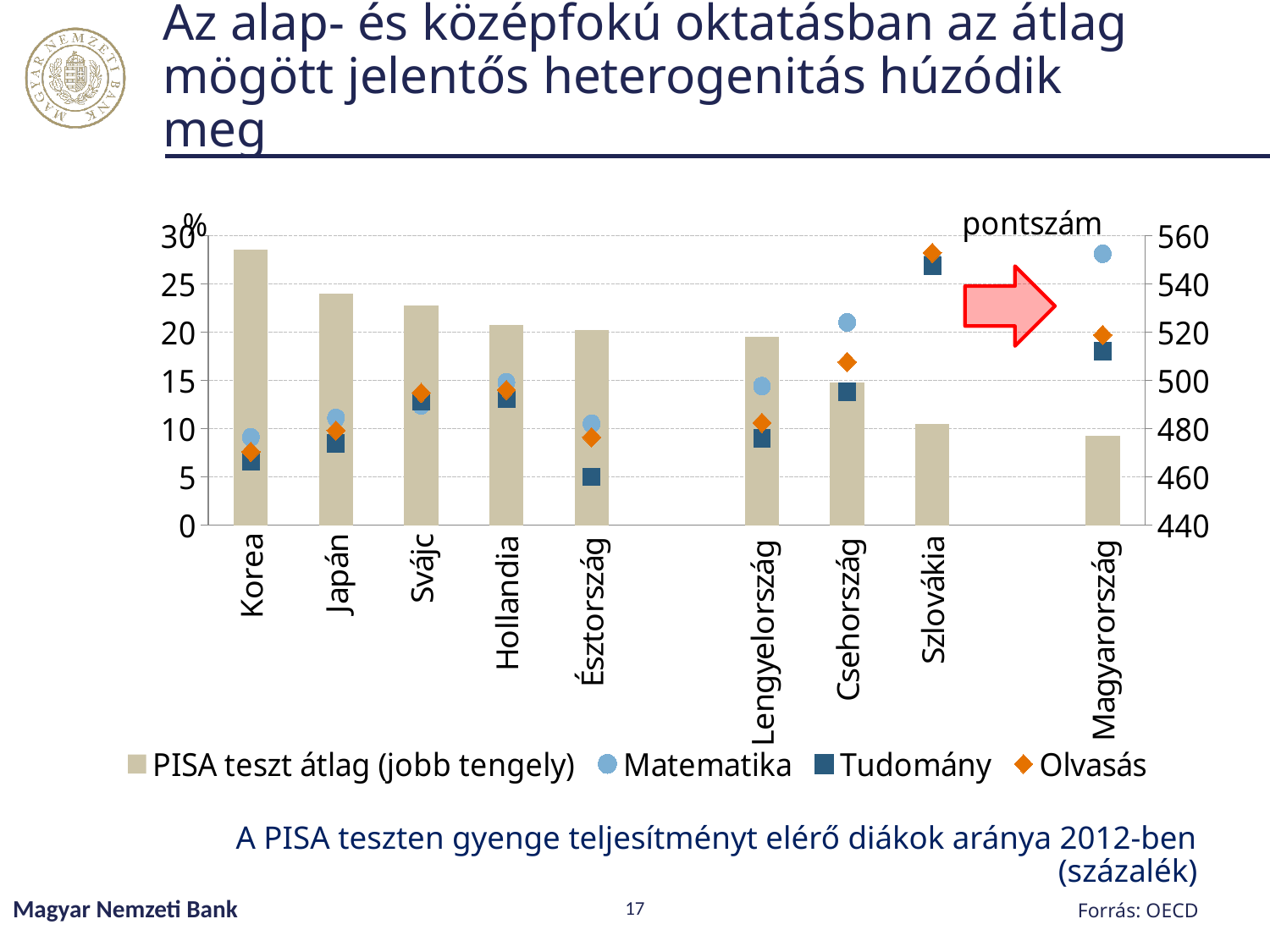
How many countries are shown on the x axis of the chart? 9 Is the Matematika value for Magyarország greater or less than 25? greater Which is larger, the Tudomány value for Szlovákia or for Hollandia? Szlovákia Which series in the chart is plotted on the right axis according to the legend? PISA teszt átlag (jobb tengely) Is the Tudomány value for Észtország greater or less than 10? less Which country has the lowest Matematika value? Korea Which country has the highest Olvasás value? Szlovákia Which country has the highest PISA teszt átlag bar? Korea What is the source given for the chart? OECD Is the PISA teszt átlag bar for Korea greater or less than 540 on the right axis? greater How many series does the chart legend list? 4 Which country has the lowest Tudomány value? Észtország